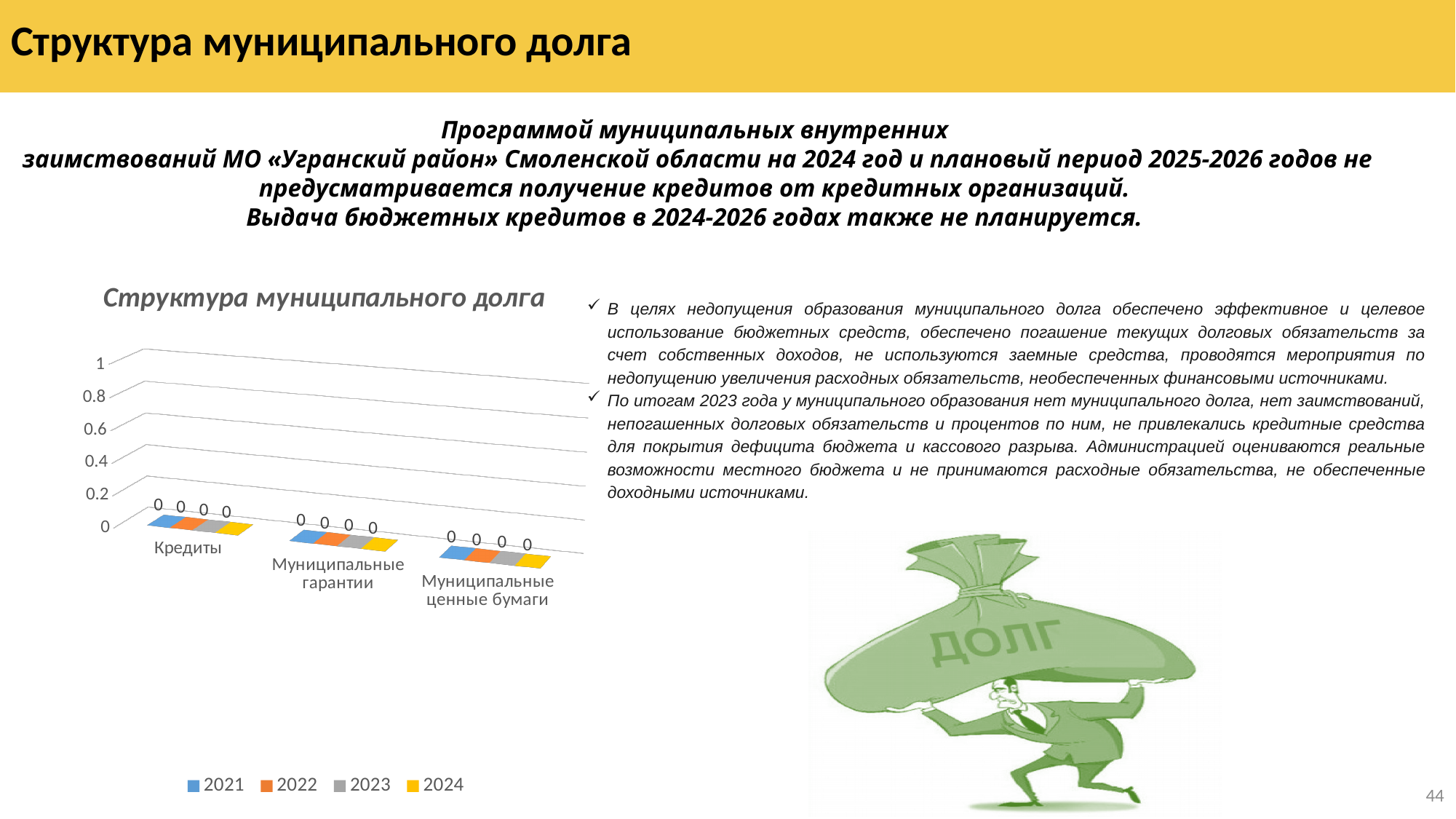
What kind of chart is shown on the slide? bar chart What is the title of the chart? Структура муниципального долга What is the value for Кредиты in 2021? 0 Is the value for Муниципальные ценные бумаги in 2022 greater or less than 0.2? less What is the value for Кредиты in 2022? 0 What is the value for Муниципальные гарантии in 2023? 0 How many categories are shown on the x axis of the chart? 3 What is the difference between the 2024 value for Кредиты and the 2024 value for Муниципальные гарантии? 0 How many series does the legend list? 4 What is the value for Муниципальные ценные бумаги in 2024? 0 Do the values for the 2023 series rise, fall or stay the same across the categories? stay the same Which series is shown in yellow in the legend? 2024